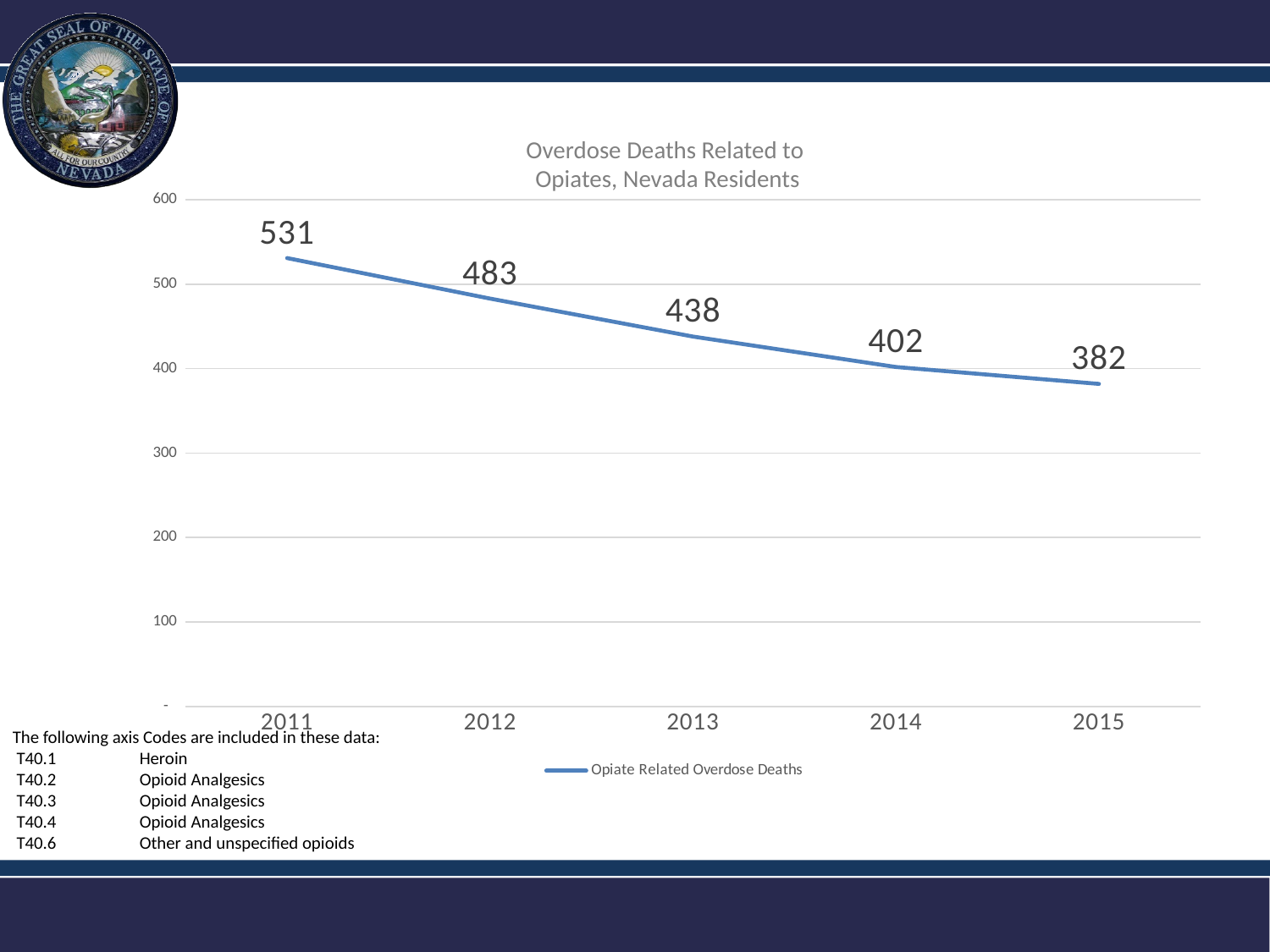
Do the values rise or fall from 2011 to 2015? fall Which is larger, the value for 2012 or the value for 2014? 2012 How many years are plotted on the chart? 5 Is the value for 2014 greater or less than 500? less Which year has the highest value? 2011 What is the difference between the values for 2011 and 2015? 149 What is the value for 2015? 382 What is the difference between the values for 2012 and 2013? 45 What kind of chart is shown? line chart What is the value for 2013? 438 Which year has the lowest value? 2015 What is the value for 2011? 531